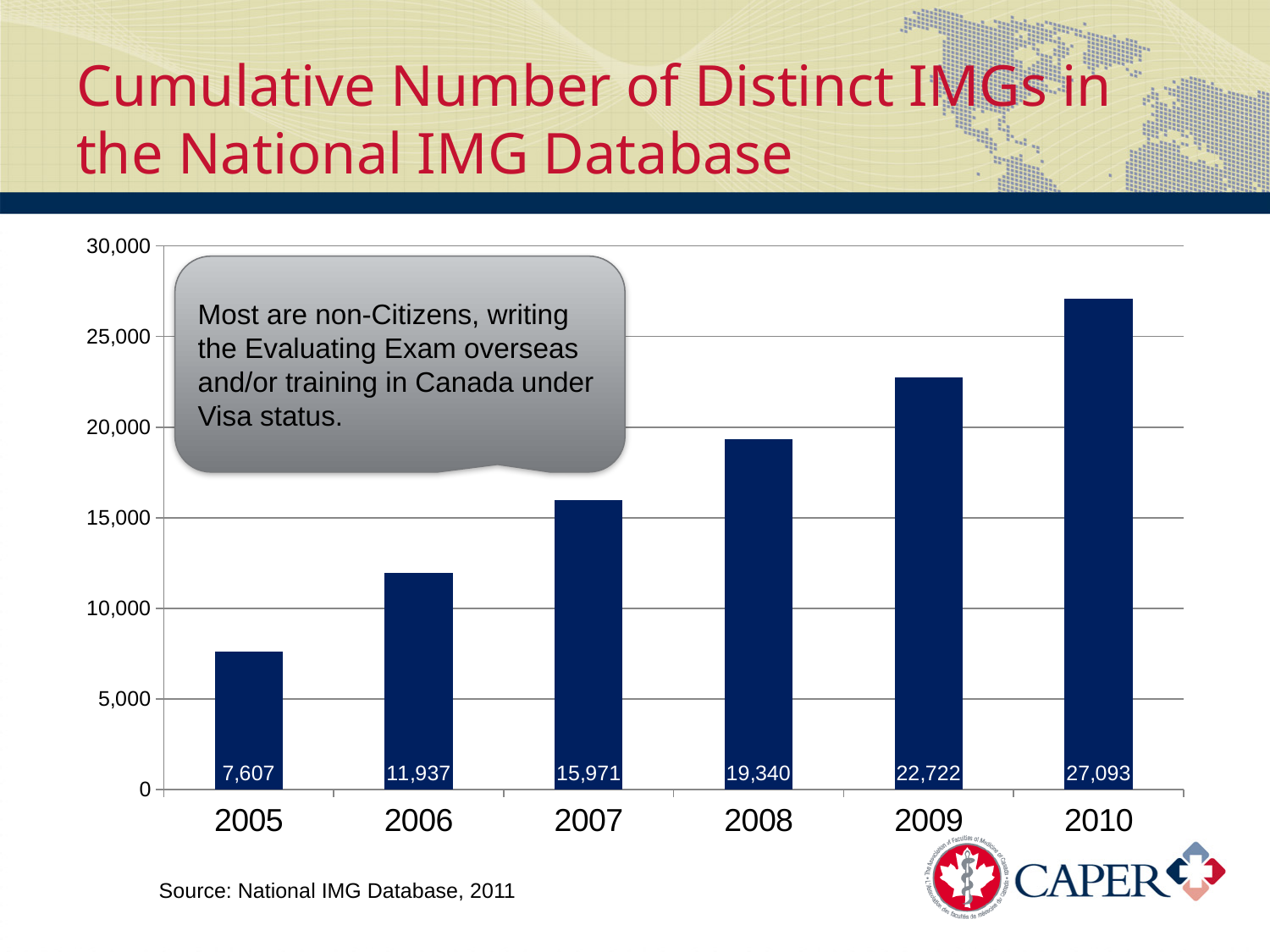
What is the cumulative number of distinct IMGs in 2010? 27,093 What is the cumulative number of distinct IMGs in 2005? 7,607 Do the values rise or fall from 2005 to 2010? Rise Which year has the highest cumulative number of distinct IMGs? 2010 What is the difference between the values for 2007 and 2006? 4,034 How many years are shown on the x axis? 6 Which year has the lowest cumulative number of distinct IMGs? 2005 What is the difference between the values for 2010 and 2009? 4,371 What kind of chart is shown on the slide? Bar chart Which is larger, the value for 2008 or the value for 2009? 2009 What is the cumulative number of distinct IMGs in 2008? 19,340 Is the value for 2007 greater or less than 15,000? greater